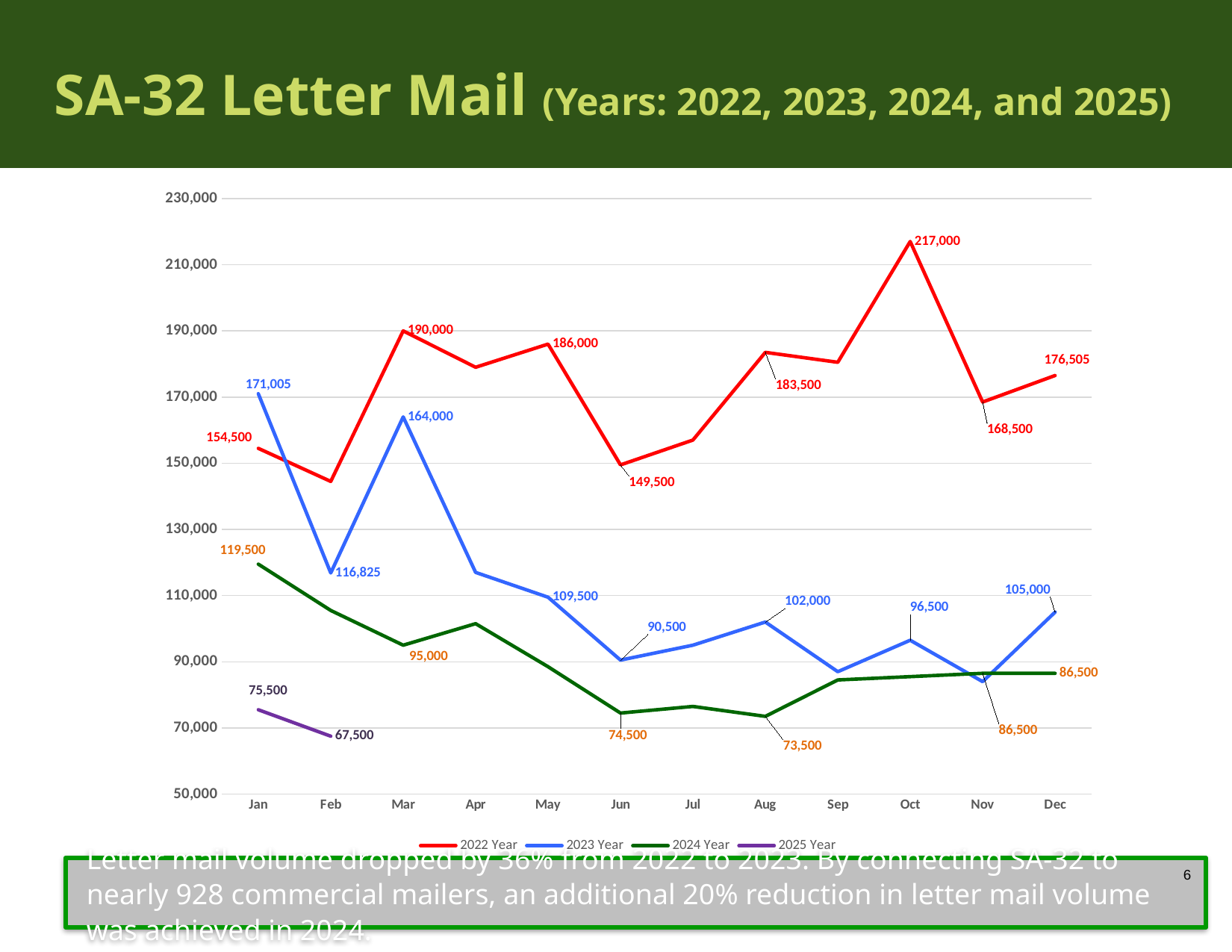
What is the value for Feb in the 2023 Year series? 116,825 In which month does the 2024 Year series reach its lowest value? Aug What is the difference between the Oct and Jan values in the 2022 Year series? 62,500 What is the difference between the Jan and Dec values in the 2024 Year series? 33,000 How many months are shown on the x axis? 12 What is the value for Feb in the 2025 Year series? 67,500 Which series has the larger value in Jan, 2022 Year or 2023 Year? 2023 Year Is the value for Feb in the 2022 Year series greater or less than 150,000? less In which month does the 2022 Year series reach its highest value? Oct What kind of chart is shown on the slide? line chart What is the value for Oct in the 2022 Year series? 217,000 How many series does the legend list? 4